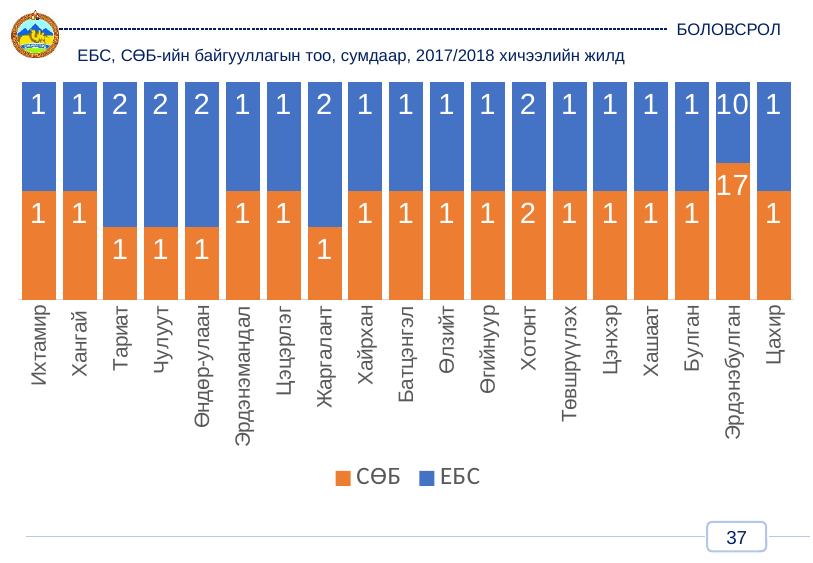
What kind of chart is shown on the slide? Stacked bar chart What is the СӨБ value for Эрдэнэбулган? 17 Which is larger for Чулуут, the ЕБС value or the СӨБ value? ЕБС What is the ЕБС value for Эрдэнэбулган? 10 What is the total of the stacked bar for Эрдэнэбулган? 27 Which category has the highest СӨБ value? Эрдэнэбулган What is the difference between the СӨБ and ЕБС values for Эрдэнэбулган? 7 What is the СӨБ value for Хотонт? 2 Which category has the highest ЕБС value? Эрдэнэбулган How many categories are shown on the x axis? 19 How many series does the legend list? 2 What is the ЕБС value for Тариат? 2